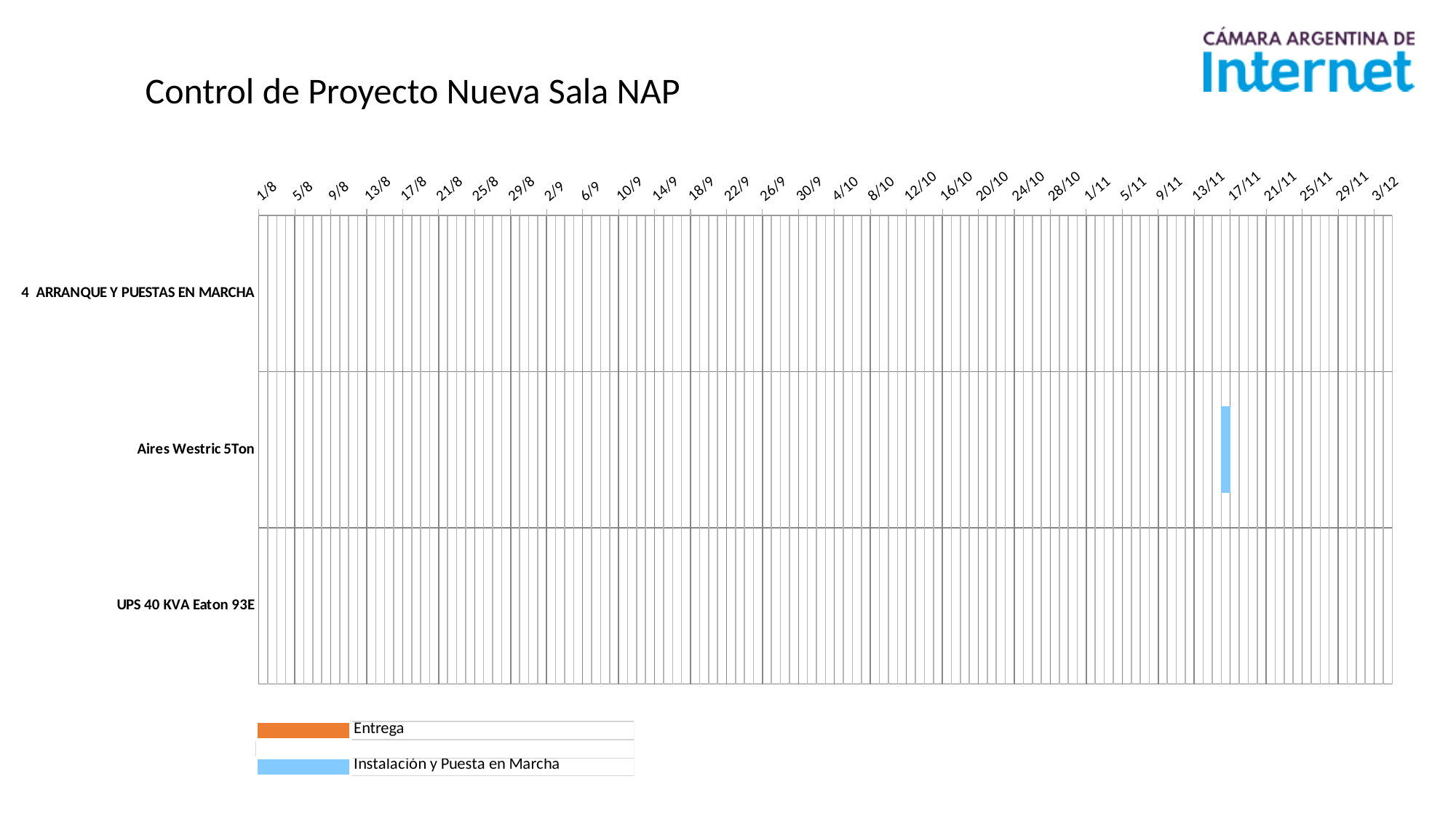
Does the bar for Aires Westric 5Ton fall before or after 21/11 on the horizontal axis? before What is the title of the chart on the slide? Control de Proyecto Nueva Sala NAP Does the bar for Aires Westric 5Ton fall before or after 1/11 on the horizontal axis? after How many task rows are listed on the vertical axis of the chart? 3 How many entries does the chart's legend list? 2 What is the last date shown on the horizontal axis? 3/12 Which task row has a bar plotted on the chart? Aires Westric 5Ton Is there any bar plotted for UPS 40 KVA Eaton 93E? No Which legend category does the bar plotted for Aires Westric 5Ton belong to? Instalación y Puesta en Marcha What is the first date shown on the horizontal axis? 1/8 According to the legend, what does the orange colour represent? Entrega According to the legend, what does the blue colour represent? Instalación y Puesta en Marcha